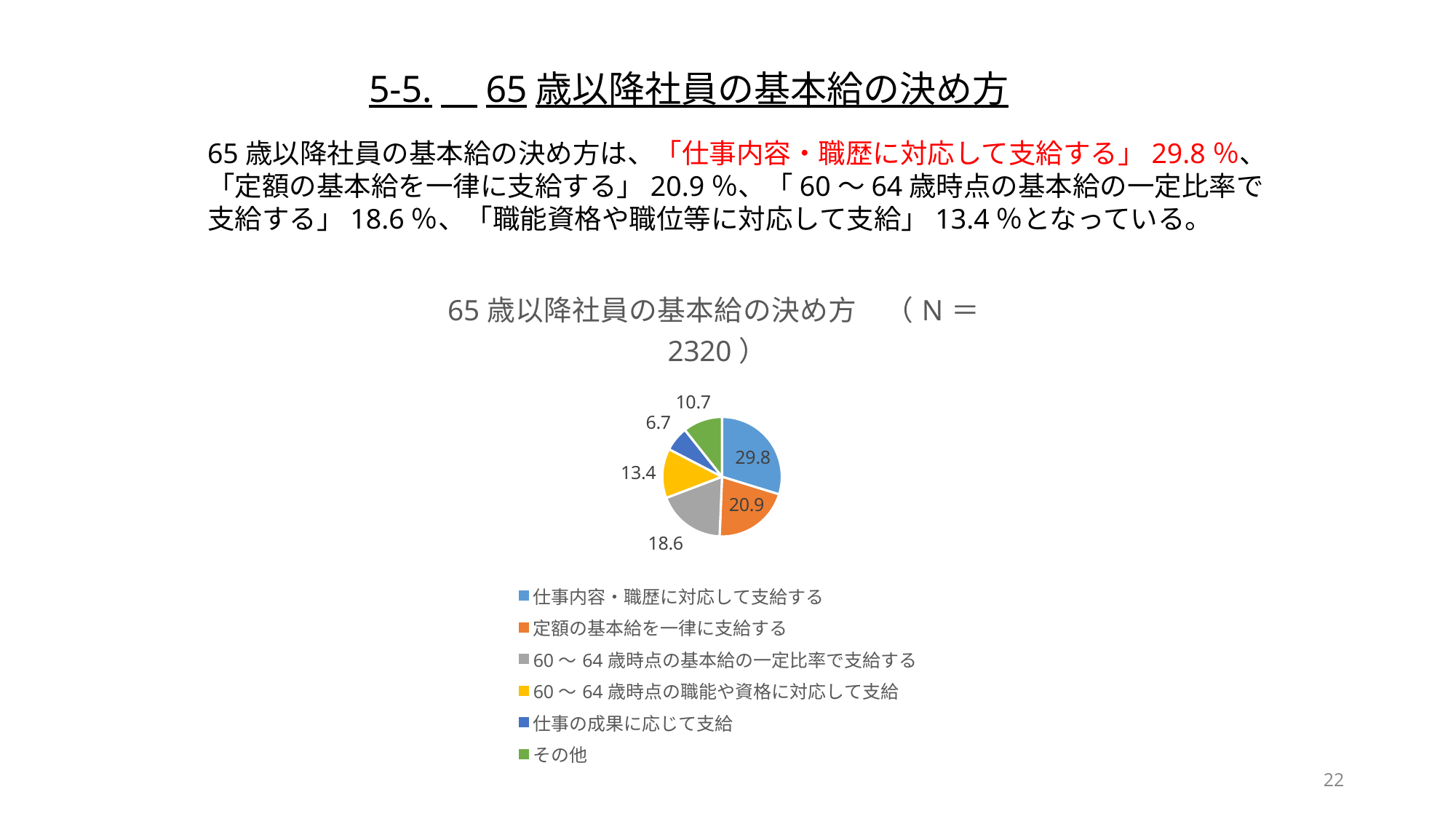
What is the value for 60～64歳時点の基本給の一定比率で支給する in the pie chart? 18.6 What is the value for 仕事内容・職歴に対応して支給する in the pie chart? 29.8 What is the value for その他 in the pie chart? 10.7 How many categories does the pie chart have? 6 Which is larger: the value for 60～64歳時点の職能や資格に対応して支給 or the value for その他? 60～64歳時点の職能や資格に対応して支給 What is the N value shown in the chart title? 2320 What type of chart is shown on the slide? pie chart What is the value for 定額の基本給を一律に支給する in the pie chart? 20.9 What is the value for 仕事の成果に応じて支給 in the pie chart? 6.7 Which category has the largest slice in the pie chart? 仕事内容・職歴に対応して支給する What is the difference between the values for 仕事内容・職歴に対応して支給する and 定額の基本給を一律に支給する? 8.9 Which category has the smallest slice in the pie chart? 仕事の成果に応じて支給